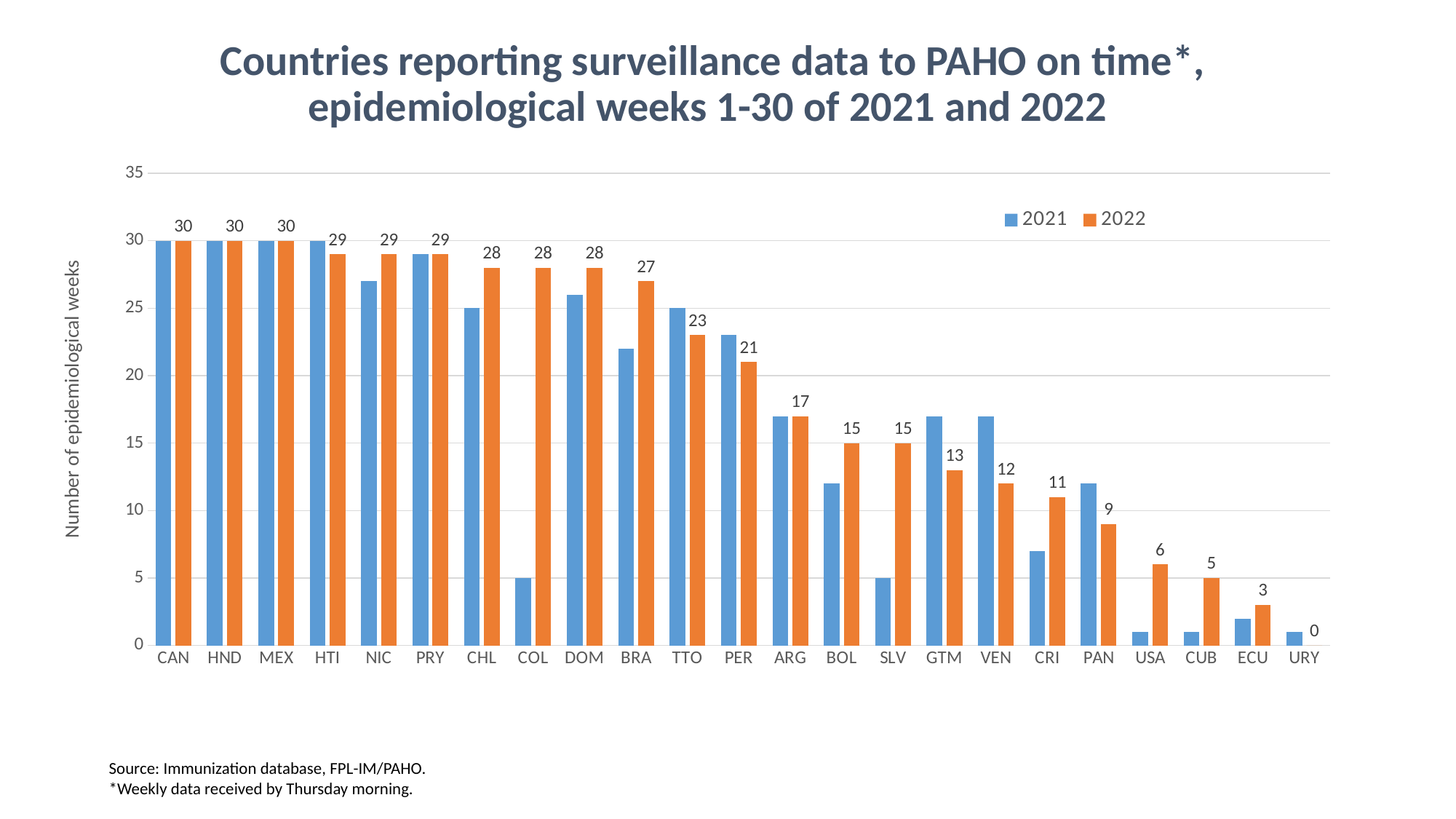
Which country has the lowest 2022 value? URY How many series does the legend list? 2 What kind of chart is shown? Bar chart What is the 2022 value for BRA? 27 Is the 2021 value for NIC greater or less than 25? greater Is the 2021 value for COL greater or less than 10? less Which has the larger 2022 value, GTM or VEN? GTM How many countries are shown on the x axis? 23 For COL, which series has the larger value, 2021 or 2022? 2022 What is the difference between the 2022 values for BRA and TTO? 4 What is the 2022 value for PAN? 9 What is the 2022 value for USA? 6